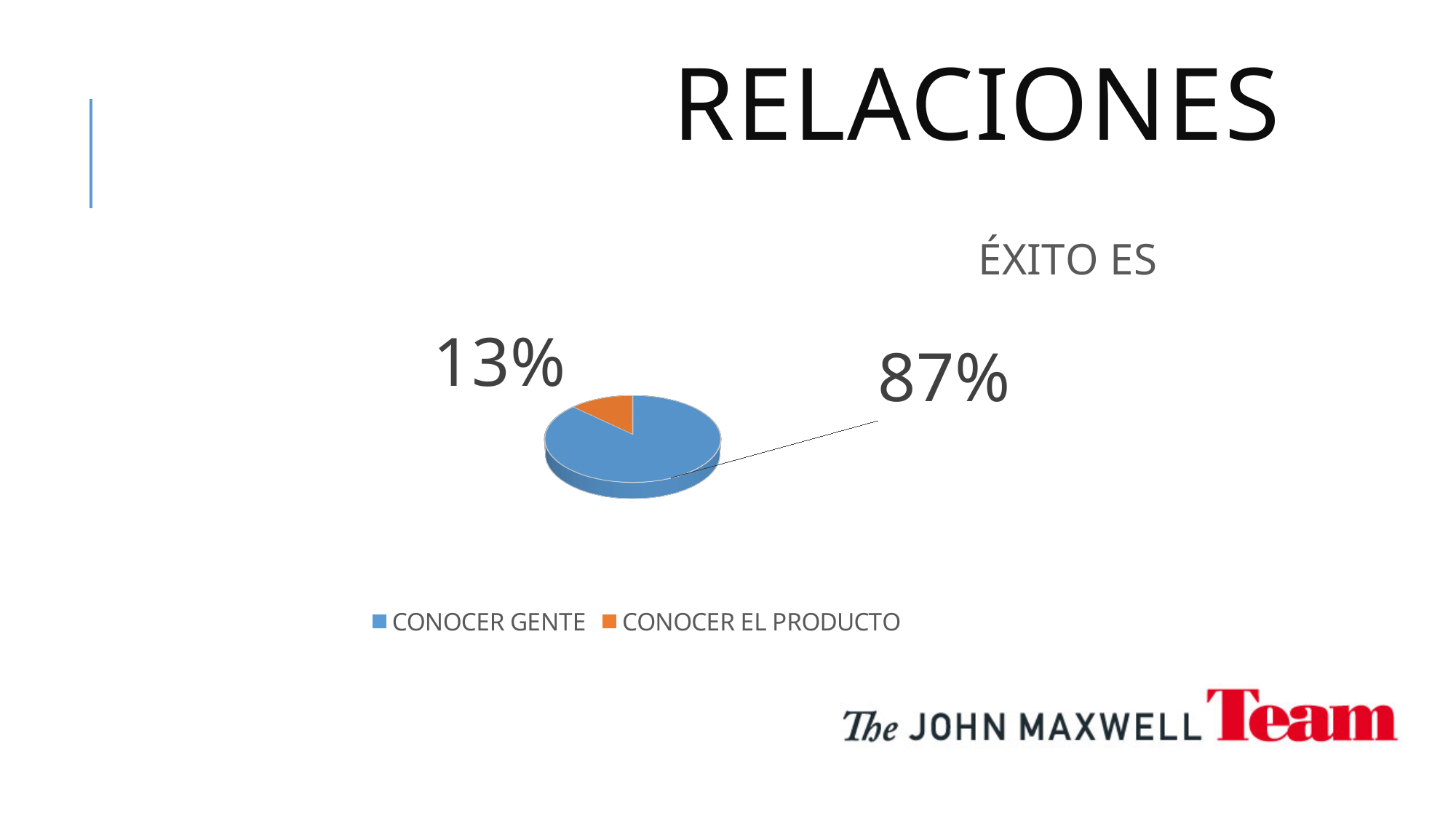
How many entries does the legend list? 2 What share of the pie does CONOCER GENTE represent? 87% What colour is the slice for CONOCER GENTE? blue Which category has the largest slice of the pie? CONOCER GENTE Which is larger, the slice for CONOCER GENTE or the slice for CONOCER EL PRODUCTO? CONOCER GENTE What share of the pie does CONOCER EL PRODUCTO represent? 13% What is the difference in percentage points between CONOCER GENTE and CONOCER EL PRODUCTO? 74 What colour is the slice for CONOCER EL PRODUCTO? orange How many slices does the pie chart have? 2 Which category has the smallest slice of the pie? CONOCER EL PRODUCTO What kind of chart is shown on the slide? pie chart